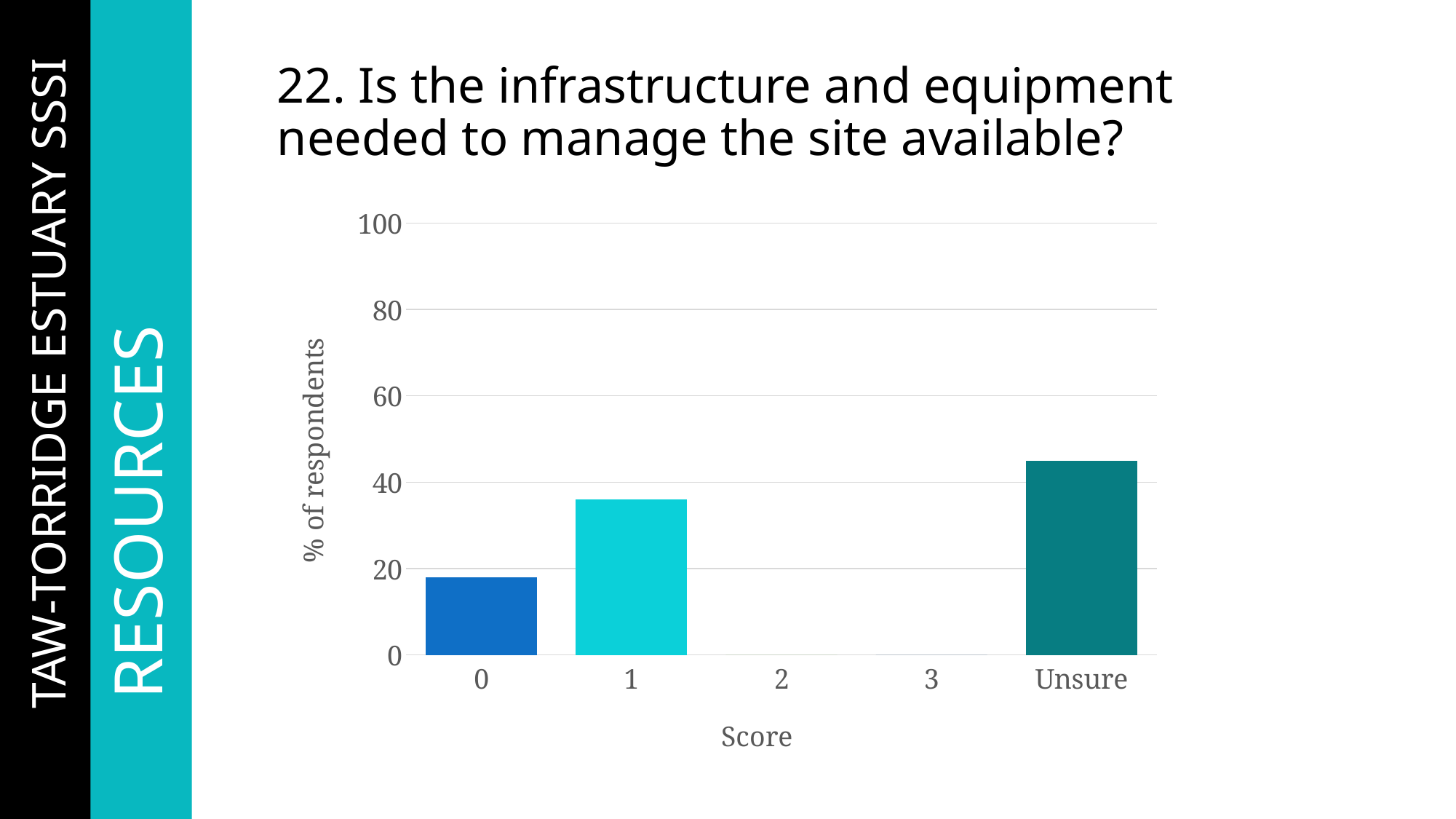
What is the label on the y axis of the chart? % of respondents Which is larger, the value for score 1 or the value for Unsure? Unsure How many score categories are shown on the x axis? 5 Is the value for score 1 greater or less than 20? greater Is the value for Unsure greater or less than 40? greater Which is larger, the value for score 0 or the value for score 1? 1 Is the value for score 1 greater or less than 40? less What is the label on the x axis of the chart? Score What kind of chart is shown on the slide? bar chart Which score category has the highest percentage of respondents? Unsure